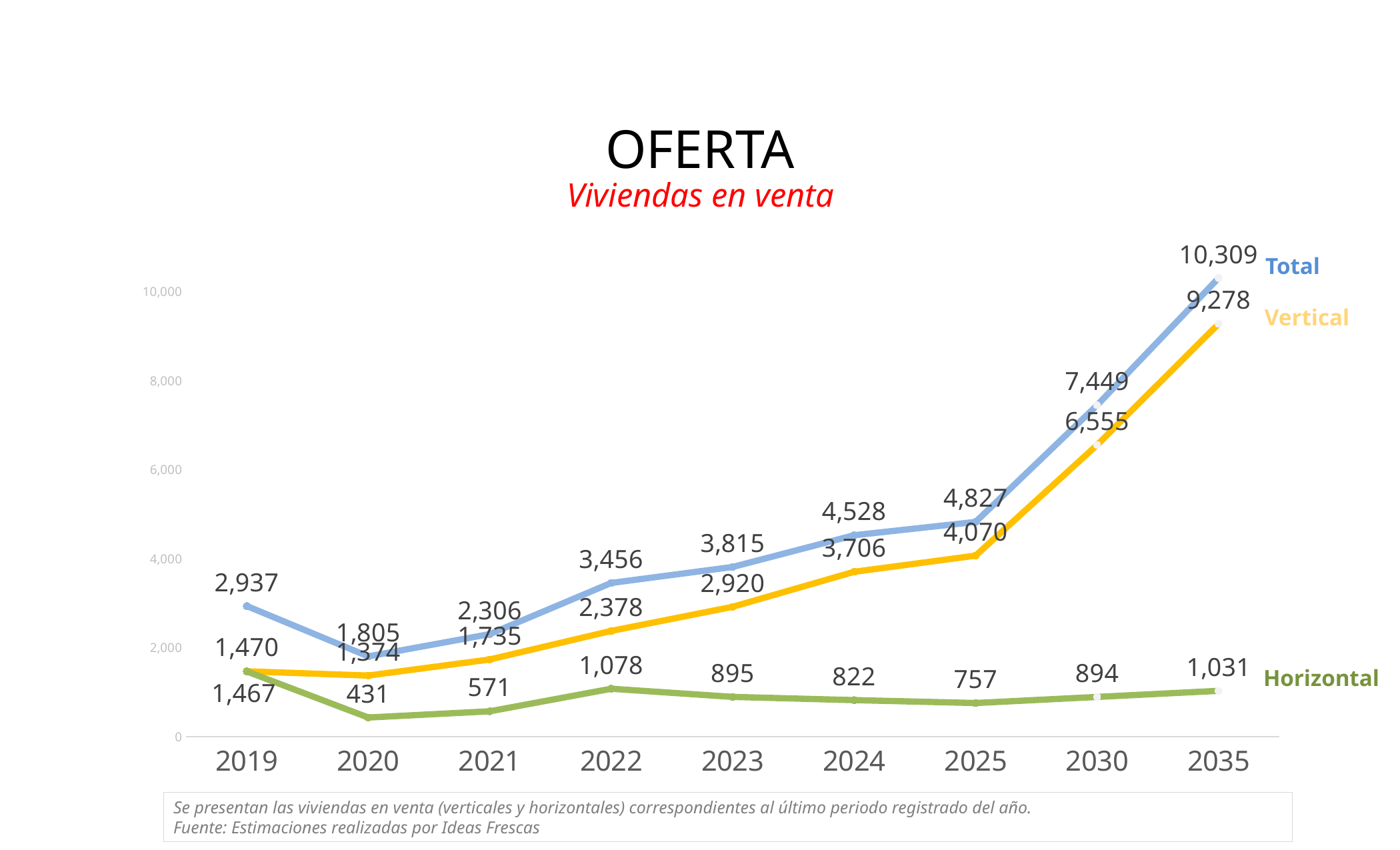
What kind of chart is shown on the slide? Line chart How many years are shown on the x axis? 9 What is the difference between the Total values for 2035 and 2030? 2,860 What is the Vertical value for 2030? 6,555 In which year is the Horizontal series at its lowest? 2020 Does the Vertical series rise or fall from 2020 to 2035? Rise How many series are plotted on the chart? 3 What is the Horizontal value for 2020? 431 In which year is the Total series at its highest? 2035 What is the Total value for 2035? 10,309 Which is larger, the Horizontal value for 2022 or for 2023? 2022 What is the Vertical value for 2023? 2,920